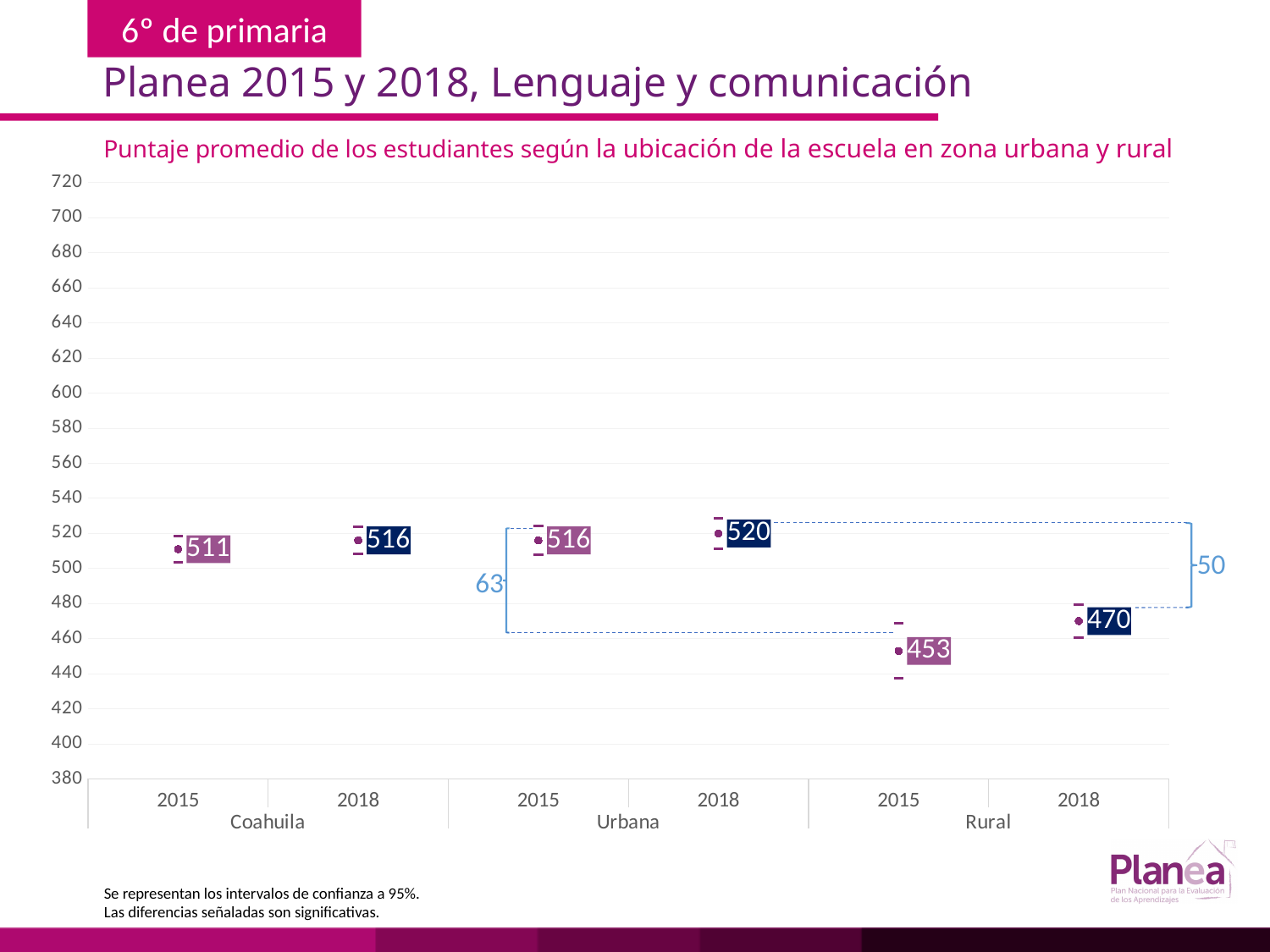
What is the average score for Coahuila in 2015? 511 What is the difference between the Urbana and Rural average scores in 2015? 63 Which group and year has the highest average score? Urbana 2018 Did the Coahuila average score rise or fall from 2015 to 2018? rise What is the average score for Rural schools in 2018? 470 What is the average score for Urbana schools in 2018? 520 How many data points are plotted on the chart? 6 Which is larger, the Rural score in 2018 or the Rural score in 2015? Rural 2018 What is the average score for Rural schools in 2015? 453 What is the average score for Coahuila in 2018? 516 What is the difference between the Urbana and Rural average scores in 2018? 50 Which group and year has the lowest average score? Rural 2015